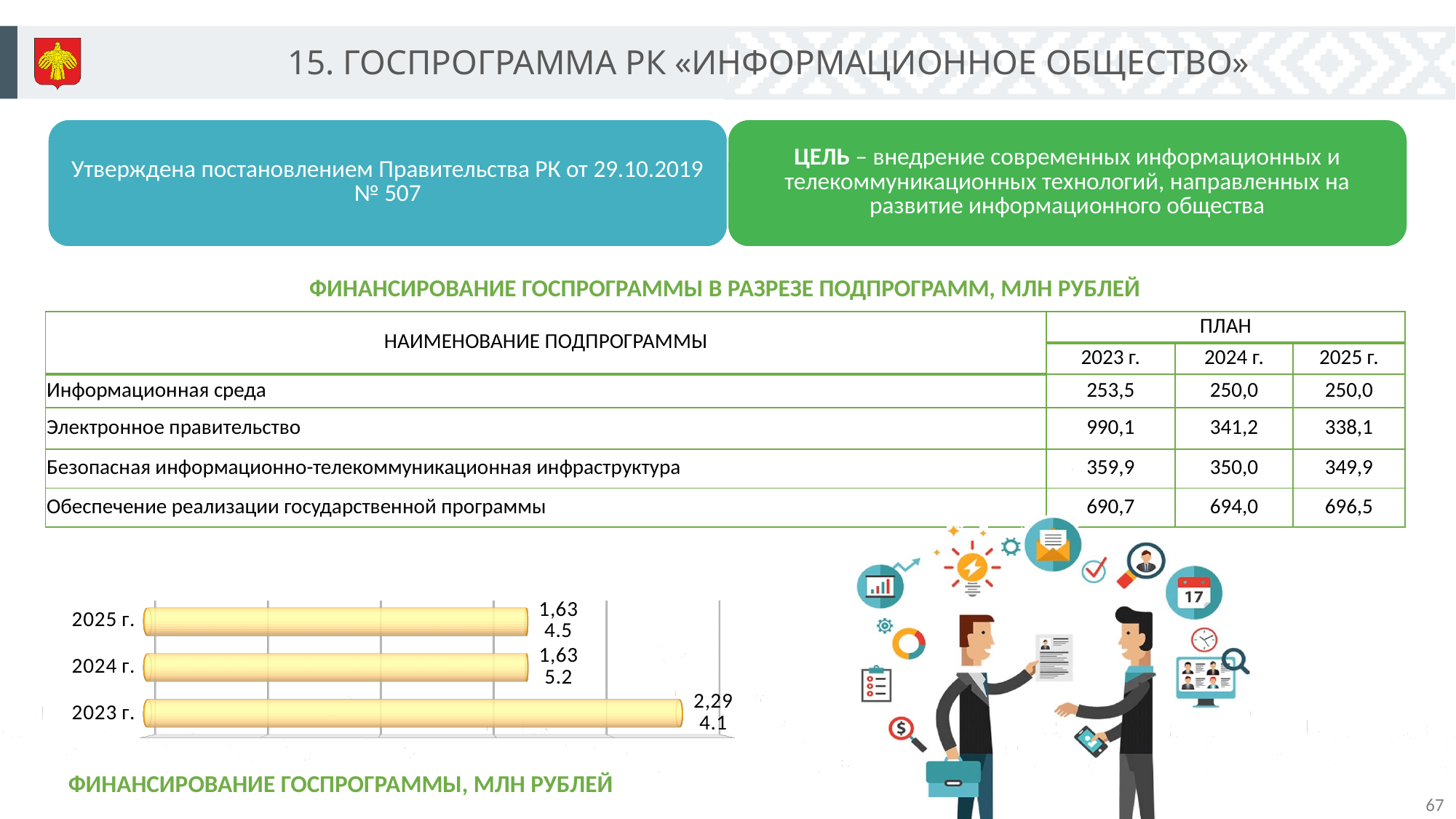
What is the title printed below the bar chart at the bottom left of the slide? ФИНАНСИРОВАНИЕ ГОСПРОГРАММЫ, МЛН РУБЛЕЙ In the bar chart at the bottom left, is the bar for 2023 г. longer or shorter than the bar for 2024 г.? longer In the bar chart at the bottom left, what is the upper data label shown at the end of the bar for 2023 г.? 2,29 In the bar chart at the bottom left, what is the lower data label shown next to the bar for 2024 г.? 5.2 In the bar chart at the bottom left, which two years have bars of equal length? 2024 г. and 2025 г. In the bar chart at the bottom left, which year has the longest bar? 2023 г. What kind of chart is shown at the bottom left of the slide? bar chart What colour are the bars in the chart at the bottom left of the slide? yellow How many years (categories) does the bar chart at the bottom left show? 3